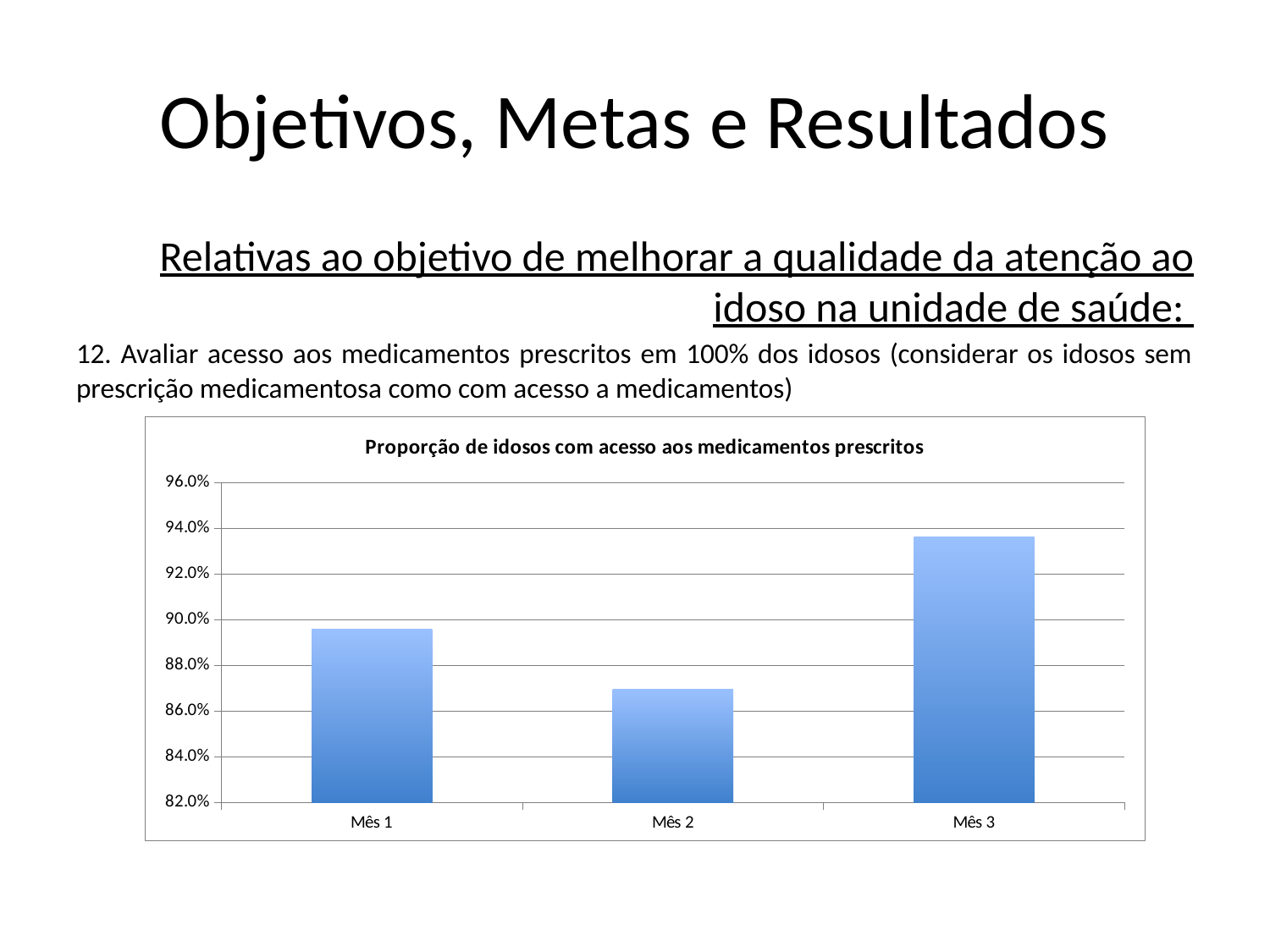
How many categories (months) are plotted on the chart? 3 Is the value for Mês 2 greater or less than 88.0%? less Is the value for Mês 1 greater or less than 88.0%? greater What kind of chart is shown on the slide? bar chart Which month has the lowest proportion of elderly with access to prescribed medications? Mês 2 Does the value rise or fall from Mês 2 to Mês 3? rise Is the value for Mês 3 greater or less than 92.0%? greater Which month has the highest proportion of elderly with access to prescribed medications? Mês 3 Which is larger, the value for Mês 1 or the value for Mês 2? Mês 1 What is the lowest value shown on the vertical axis of the chart? 82.0% What is the title of the chart? Proporção de idosos com acesso aos medicamentos prescritos